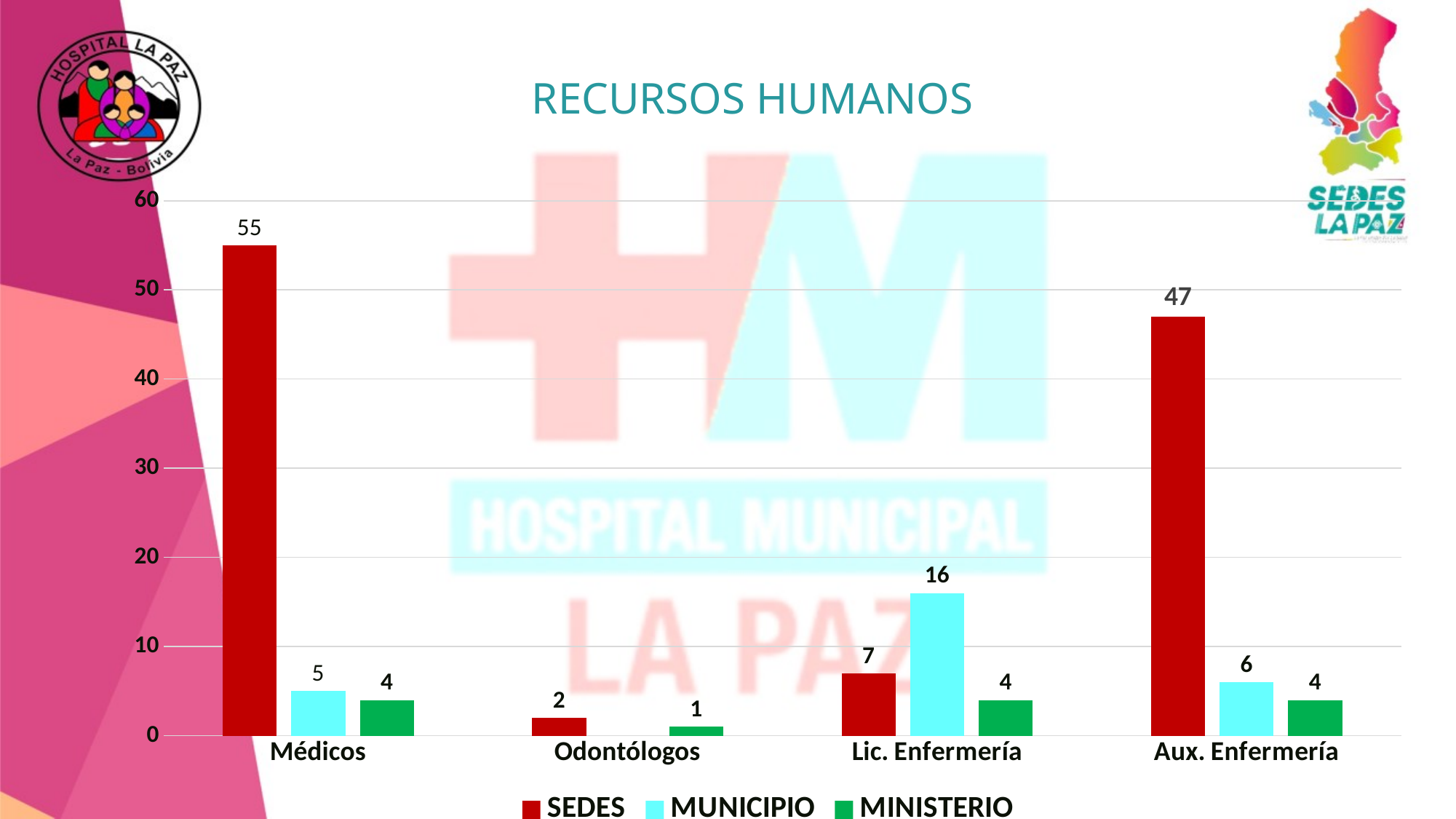
How many categories are shown on the x axis? 4 Which is larger for Lic. Enfermería, the SEDES value or the MUNICIPIO value? MUNICIPIO What is the difference between the SEDES values for Médicos and Aux. Enfermería? 8 What is the SEDES value for Aux. Enfermería? 47 How many series does the legend list? 3 What is the title of the chart? RECURSOS HUMANOS What is the SEDES value for Médicos? 55 What kind of chart is shown on the slide? Bar chart Which category has the highest SEDES value? Médicos Which category has the lowest SEDES value? Odontólogos What is the MUNICIPIO value for Lic. Enfermería? 16 What is the MINISTERIO value for Odontólogos? 1